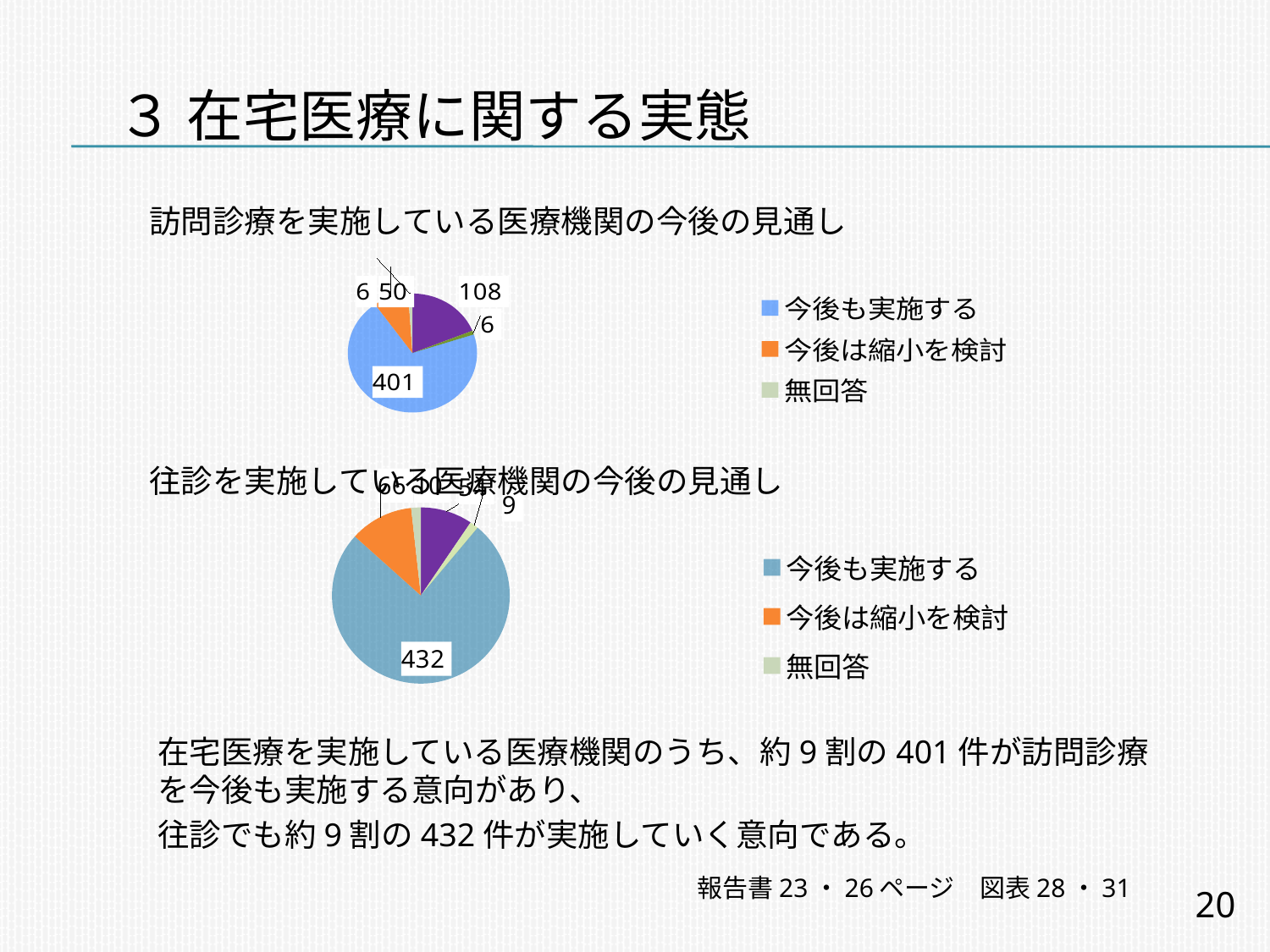
In the bottom pie chart (往診を実施している医療機関の今後の見通し), what is the value for 今後も実施する? 432 In the top pie chart (訪問診療を実施している医療機関の今後の見通し), which category has the largest slice? 今後も実施する Which chart shows the larger value for 今後も実施する: the top chart (訪問診療) or the bottom chart (往診)? The bottom chart (往診) How many entries does the legend of the top chart (訪問診療を実施している医療機関の今後の見通し) list? 3 In the top pie chart (訪問診療を実施している医療機関の今後の見通し), which is larger: 今後も実施する or 今後は縮小を検討? 今後も実施する In the top pie chart (訪問診療を実施している医療機関の今後の見通し), what is the value for 今後も実施する? 401 In the top pie chart (訪問診療を実施している医療機関の今後の見通し), what is the difference between the values for 今後も実施する and 今後は縮小を検討? 351 What kind of chart is the bottom chart (往診を実施している医療機関の今後の見通し)? Pie chart In the bottom pie chart (往診を実施している医療機関の今後の見通し), which category has the largest slice? 今後も実施する In the top pie chart (訪問診療を実施している医療機関の今後の見通し), what is the value for 今後は縮小を検討? 50 What kind of chart is the top chart (訪問診療を実施している医療機関の今後の見通し)? Pie chart In the bottom chart (往診を実施している医療機関の今後の見通し), what colour represents 今後は縮小を検討 in the legend? Orange